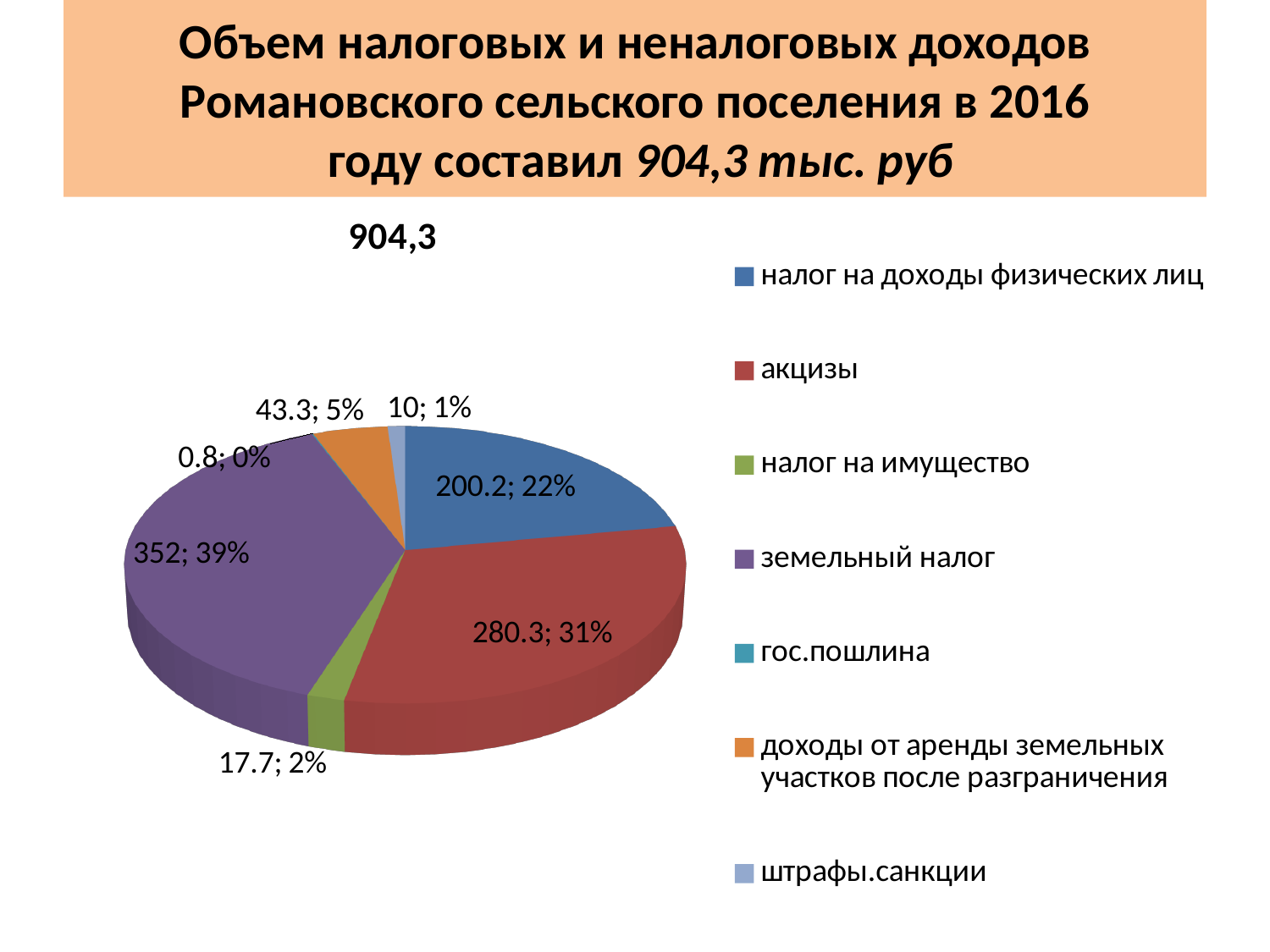
What is the value for акцизы? 280.3 Which category has the smallest slice of the pie? гос.пошлина What share of the pie does земельный налог represent? 39% What is the difference between the values for земельный налог and акцизы? 71.7 What share of the pie does налог на имущество represent? 2% What is the value for доходы от аренды земельных участков после разграничения? 43.3 Which is larger, the value for акцизы or the value for налог на доходы физических лиц? акцизы What is the value for налог на доходы физических лиц? 200.2 What is the value for земельный налог? 352 How many categories does the legend list? 7 What kind of chart is shown on the slide? pie chart Which category has the largest slice of the pie? земельный налог